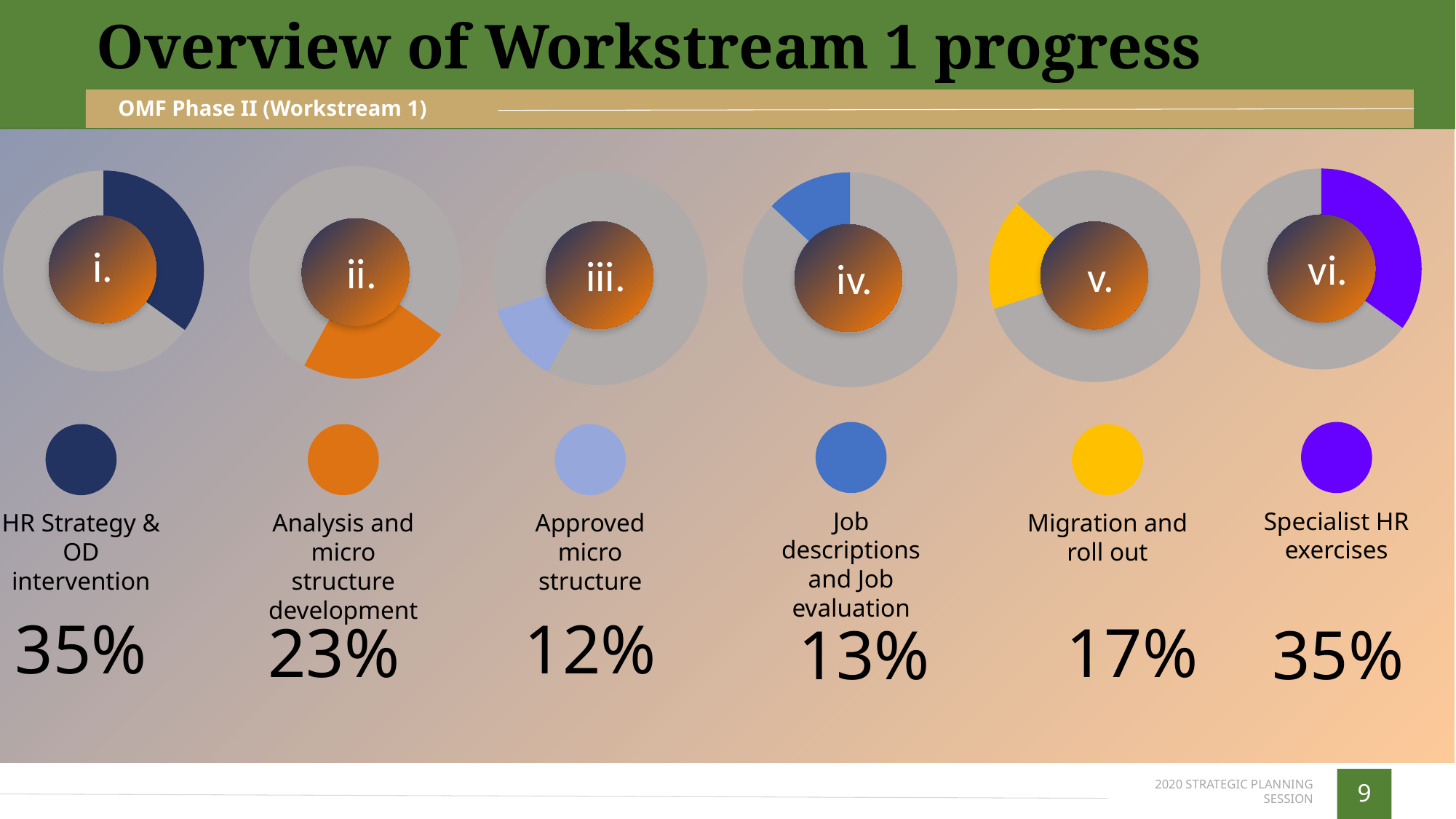
What percentage progress is shown for the chart labelled i. (HR Strategy & OD intervention)? 35% What percentage progress is shown for the chart labelled iv. (Job descriptions and Job evaluation)? 13% What percentage progress is shown for the chart labelled ii. (Analysis and micro structure development)? 23% What percentage progress is shown for the chart labelled iii. (Approved micro structure)? 12% What is the difference between the progress percentage for chart i. (HR Strategy & OD intervention) and chart ii. (Analysis and micro structure development)? 12% How many doughnut charts are shown on the slide? 6 Which workstream item shows the lowest progress percentage on the slide? Approved micro structure (iii.) Which has a higher progress percentage: chart v. (Migration and roll out) or chart iv. (Job descriptions and Job evaluation)? Migration and roll out (v.) What colour is the filled segment of the chart labelled v. (Migration and roll out)? Yellow What kind of chart is used to show each workstream item's progress? Doughnut chart What percentage progress is shown for the chart labelled vi. (Specialist HR exercises)? 35% What percentage progress is shown for the chart labelled v. (Migration and roll out)? 17%